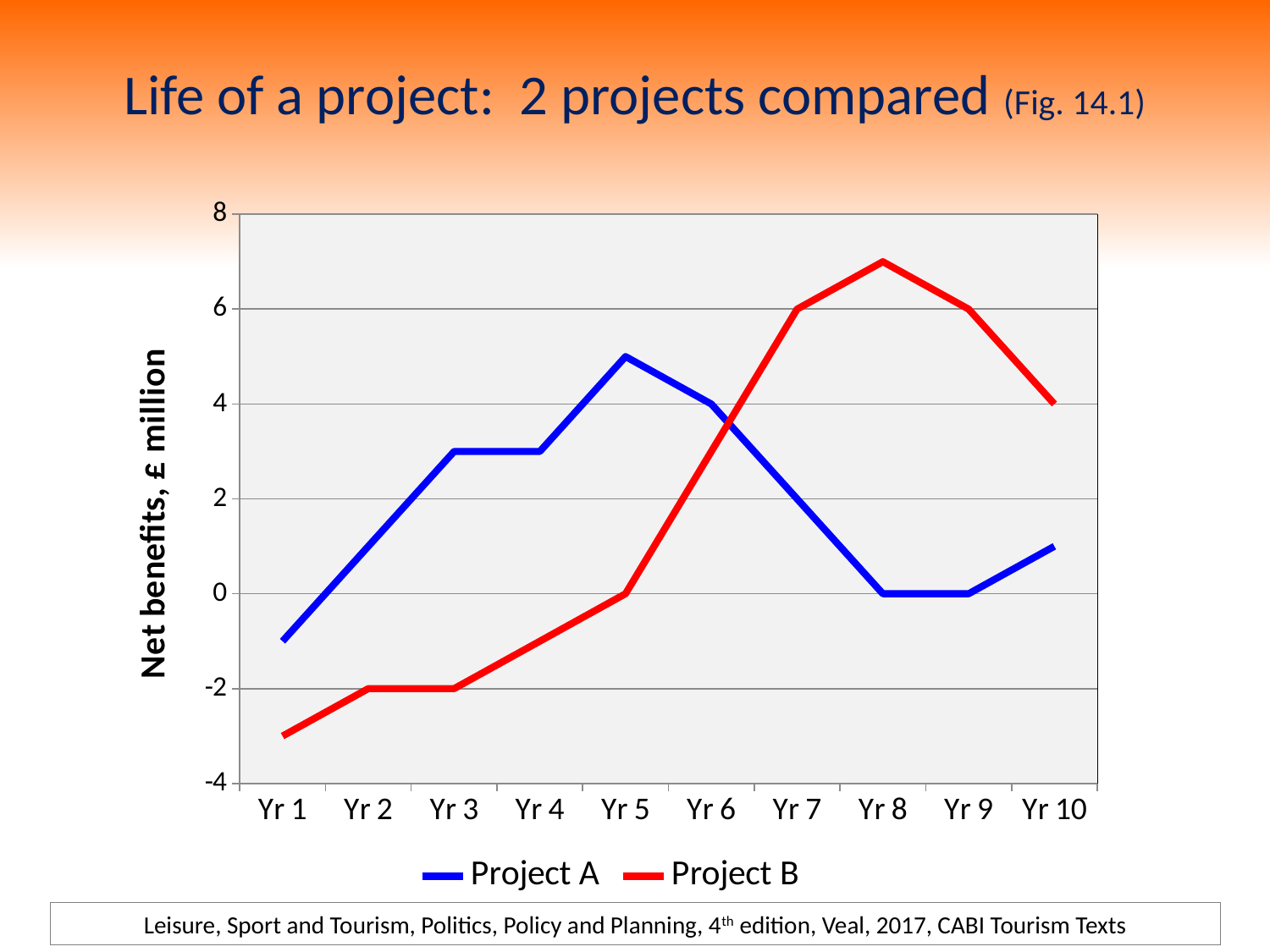
What kind of chart is shown on the slide? line chart In which year is Project B's net benefit lowest? Yr 1 In which year does Project B reach its highest net benefit? Yr 8 In which year does Project A reach its highest net benefit? Yr 5 What is the net benefit for Project A in Yr 8? 0 How many years are plotted along the x axis? 10 What is the difference between Project B's net benefit in Yr 7 and in Yr 10? 2 What is the net benefit for Project B in Yr 7? 6 What is the net benefit for Project B in Yr 10? 4 How many series does the legend list? 2 Is the value for Project B in Yr 8 greater or less than 6? greater Which project has the higher net benefit in Yr 3? Project A